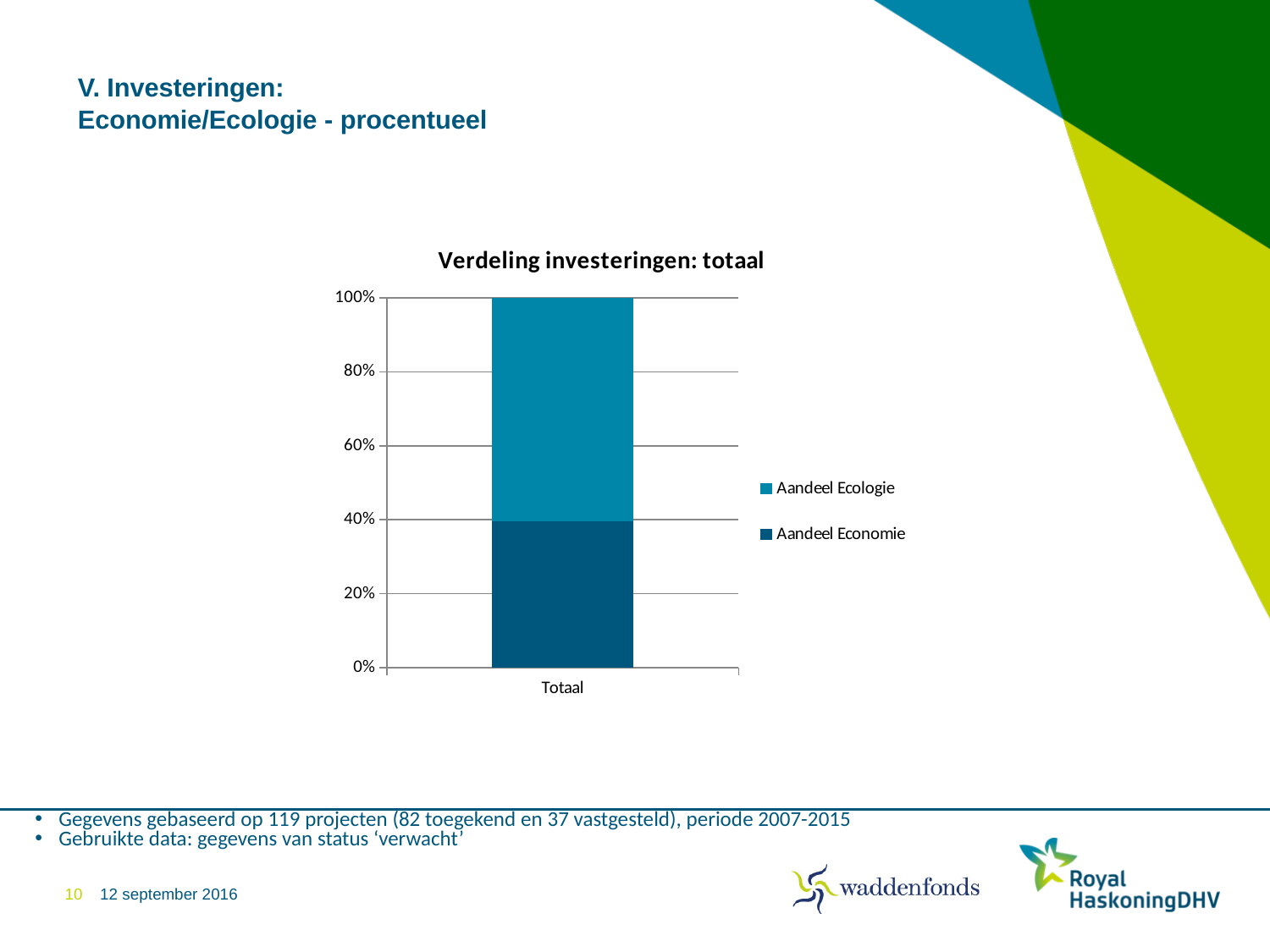
Which series are listed in the chart legend? Aandeel Ecologie, Aandeel Economie What kind of chart is shown on the slide? stacked bar chart Which series is shown at the bottom of the stacked bar? Aandeel Economie Which series has the larger share in the Totaal bar, Aandeel Ecologie or Aandeel Economie? Aandeel Ecologie What is the label of the single category on the x axis? Totaal What is the total height of the stacked Totaal bar? 100% Is the share of Aandeel Ecologie in the Totaal bar greater or less than 40%? greater Is the share of Aandeel Economie in the Totaal bar greater or less than 20%? greater How many categories are shown on the x axis of the chart? 1 What is the title of the chart? Verdeling investeringen: totaal How many series does the chart legend list? 2 Is the share of Aandeel Economie in the Totaal bar greater or less than 60%? less